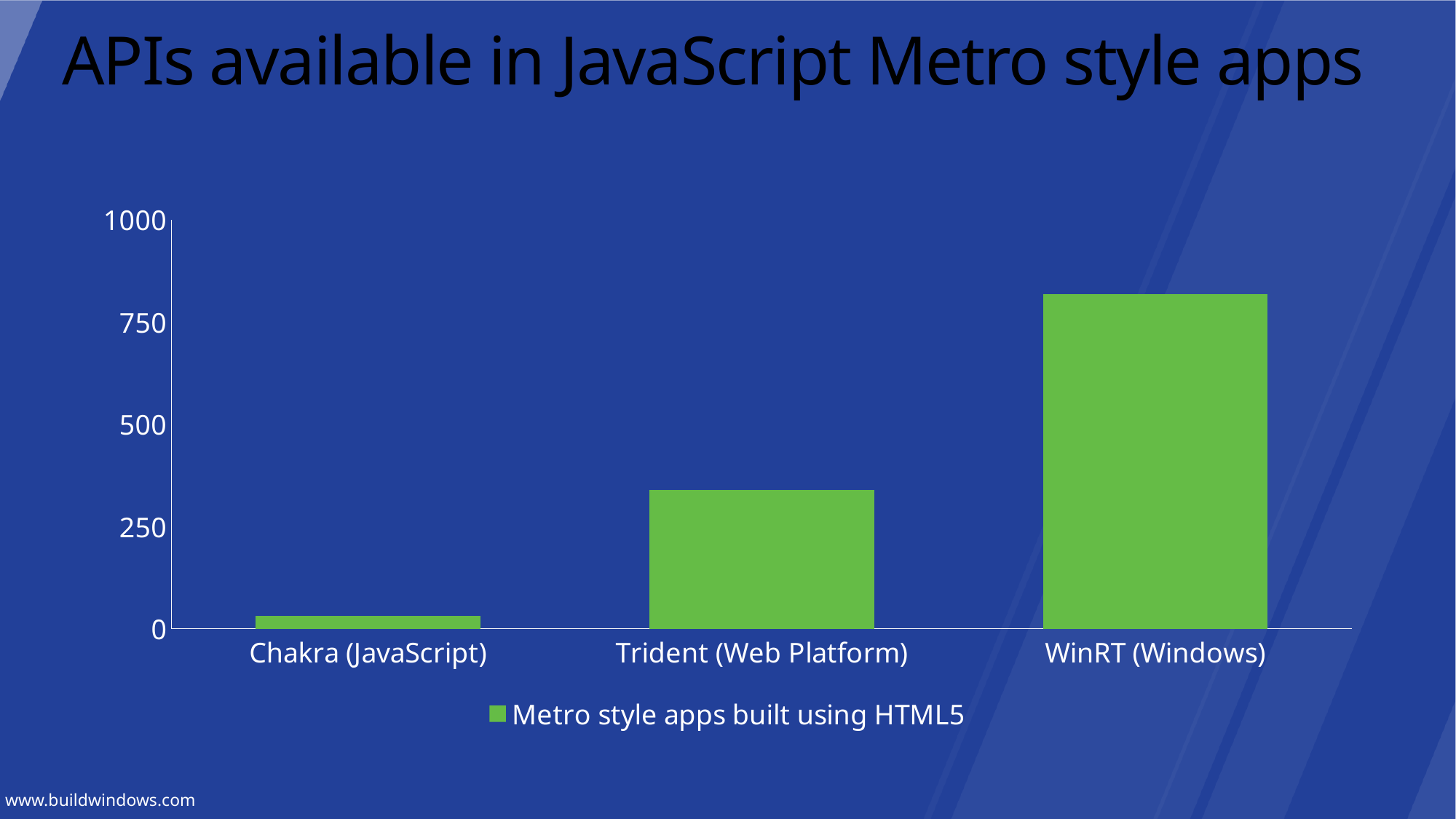
Is the value for Trident (Web Platform) greater or less than 500? less Do the values rise or fall moving left to right along the x axis? rise Which category has the lowest value? Chakra (JavaScript) What kind of chart is shown on the slide? bar chart Is the value for WinRT (Windows) greater or less than 750? greater How many series does the legend list? 1 Which is larger, the value for Trident (Web Platform) or the value for Chakra (JavaScript)? Trident (Web Platform) Which category has the highest value? WinRT (Windows) What is the title of the chart? APIs available in JavaScript Metro style apps What series name does the legend show? Metro style apps built using HTML5 Is the value for Chakra (JavaScript) greater or less than 250? less How many categories are plotted on the x axis? 3